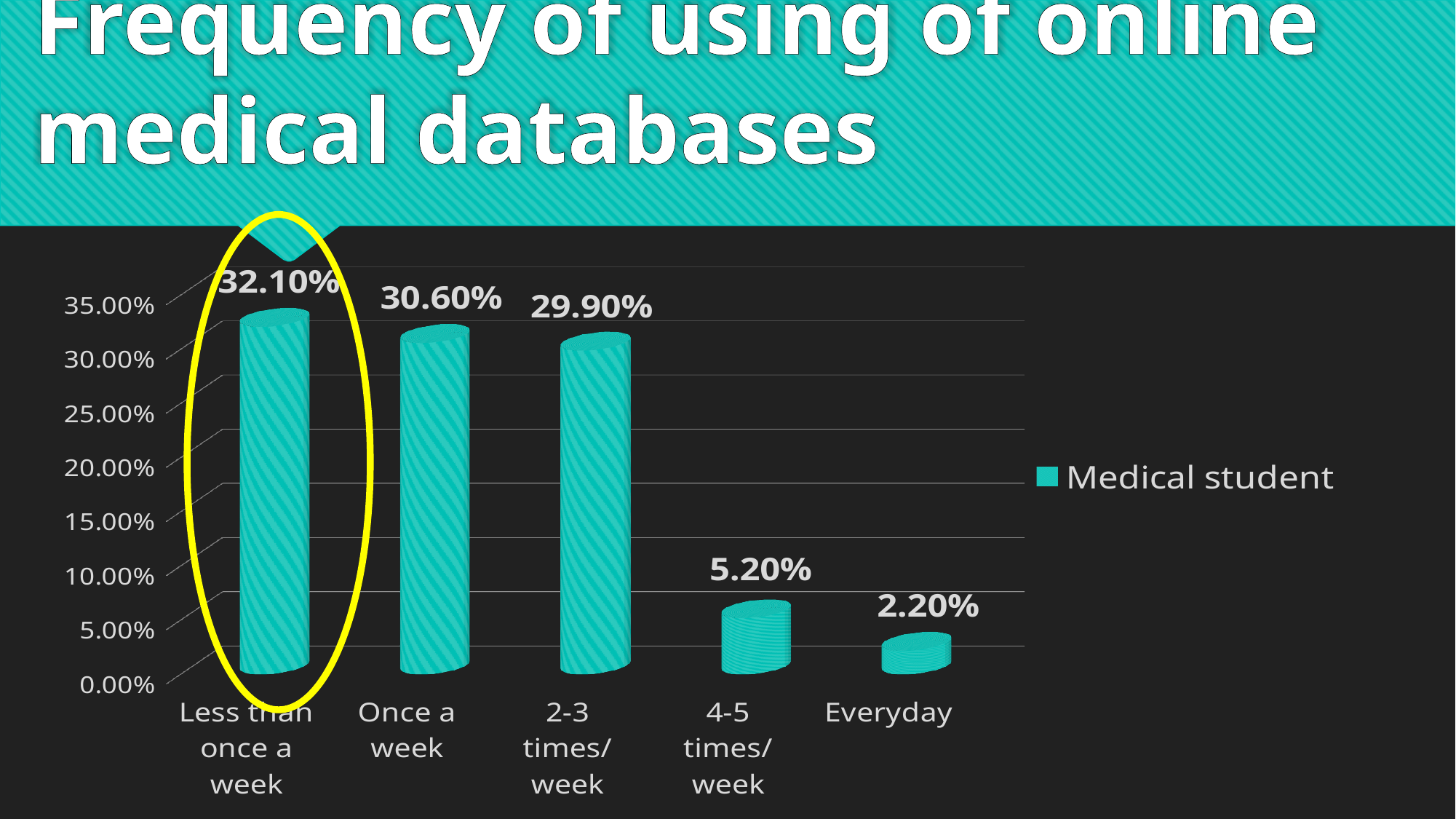
What is the value for "Once a week"? 30.60% How many series does the legend list? 1 What kind of chart is shown on the slide? Bar chart How many categories are shown on the x axis? 5 What is the value for "Less than once a week"? 32.10% Which category has the lowest value? Everyday What is the value for "2-3 times/week"? 29.90% Which is larger, the value for "Once a week" or the value for "2-3 times/week"? Once a week What is the value for "Everyday"? 2.20% What is the difference between the values for "4-5 times/week" and "Everyday"? 3.00% Which category has the highest value? Less than once a week What series name is shown in the legend? Medical student